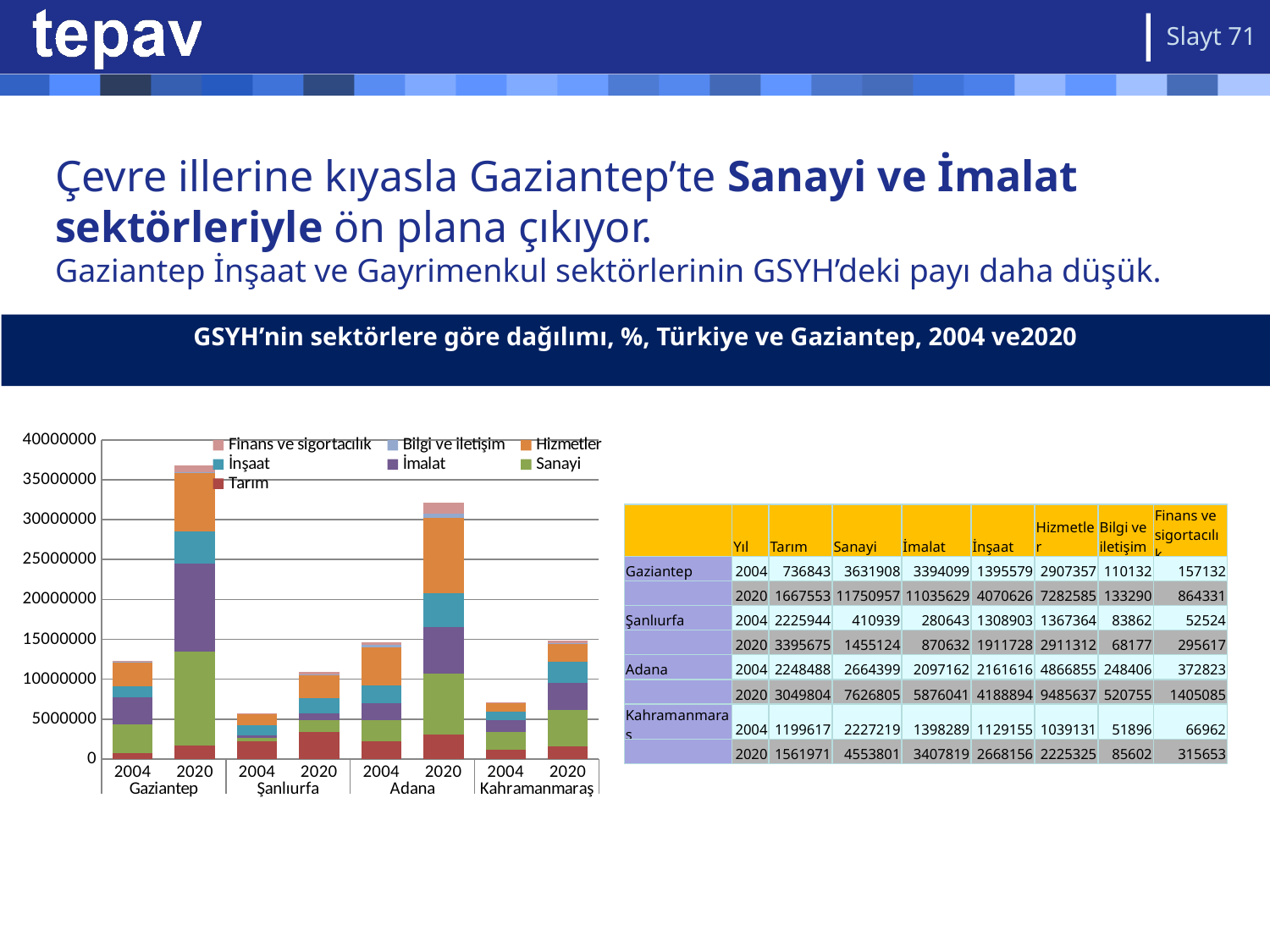
For each province, does the bar rise or fall from 2004 to 2020? Rises Which series is shown in green in the chart legend? Sanayi Is the total of the Gaziantep 2020 bar greater or less than 35000000? greater Which bar is taller, Adana 2004 or Gaziantep 2004? Adana 2004 What kind of chart is shown on the slide? Stacked bar chart Which bar is taller, Kahramanmaraş 2020 or Şanlıurfa 2020? Kahramanmaraş 2020 Which bar in the chart is the tallest? Gaziantep 2020 How many series does the chart legend list? 7 According to the table beside the chart, what is the Sanayi value for Gaziantep in 2020? 11750957 Is the total of the Şanlıurfa 2004 bar greater or less than 10000000? less How many bars are plotted in the chart? 8 Which bar in the chart is the shortest? Şanlıurfa 2004